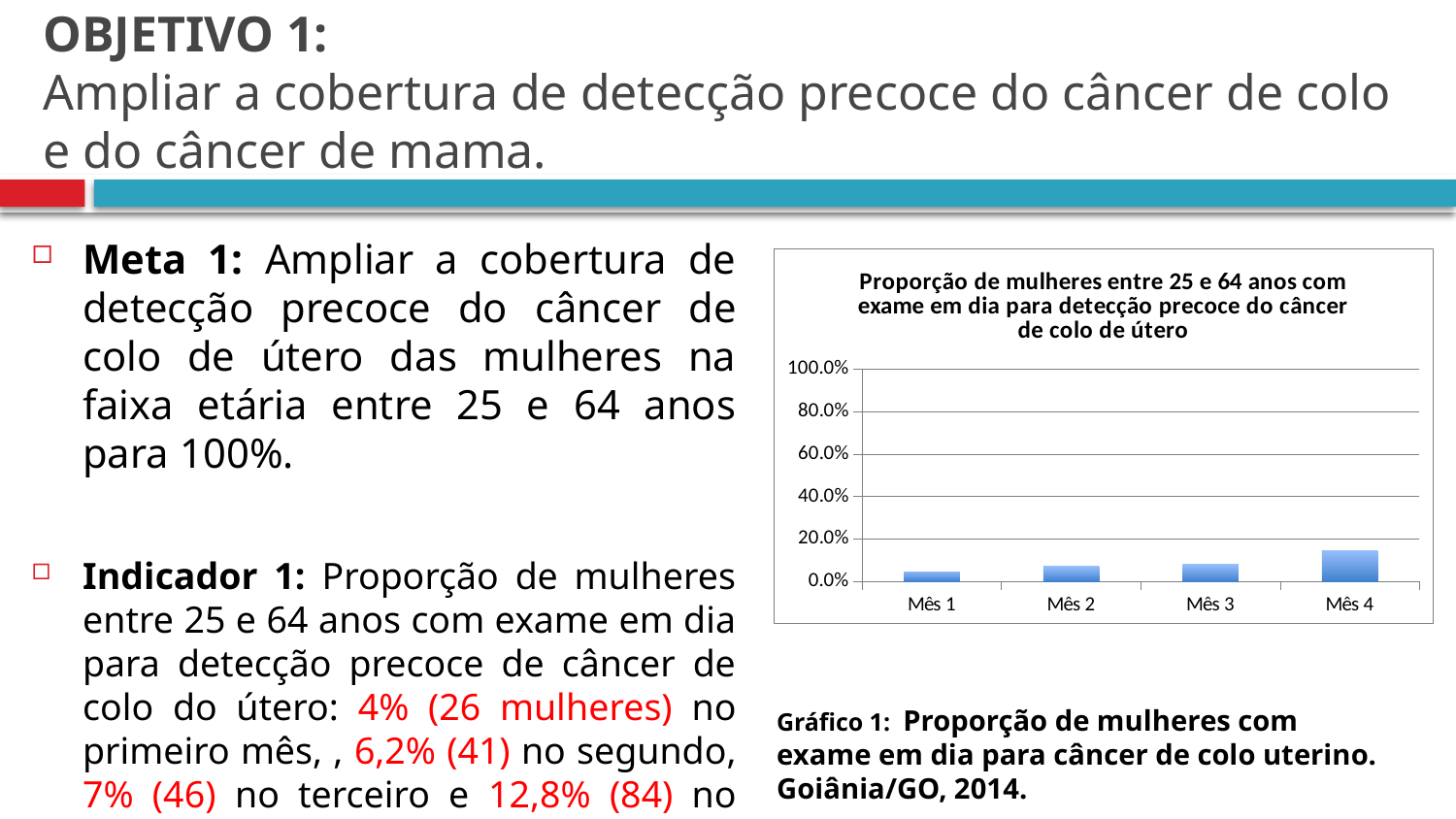
Which month has the lowest bar in the chart? Mês 1 Is the value for Mês 4 greater or less than 20.0%? less How many categories (months) are shown on the x axis of the chart? 4 What is the highest value shown on the y axis of the chart? 100.0% What type of chart is shown on the slide? bar chart Is the value for Mês 3 greater or less than 40.0%? less Do the bar values rise or fall from Mês 1 to Mês 4? rise Which month has the highest bar in the chart? Mês 4 Which is larger, the value for Mês 4 or the value for Mês 1? Mês 4 Is the value for Mês 1 greater or less than 20.0%? less What is the title of the chart? Proporção de mulheres entre 25 e 64 anos com exame em dia para detecção precoce do câncer de colo de útero